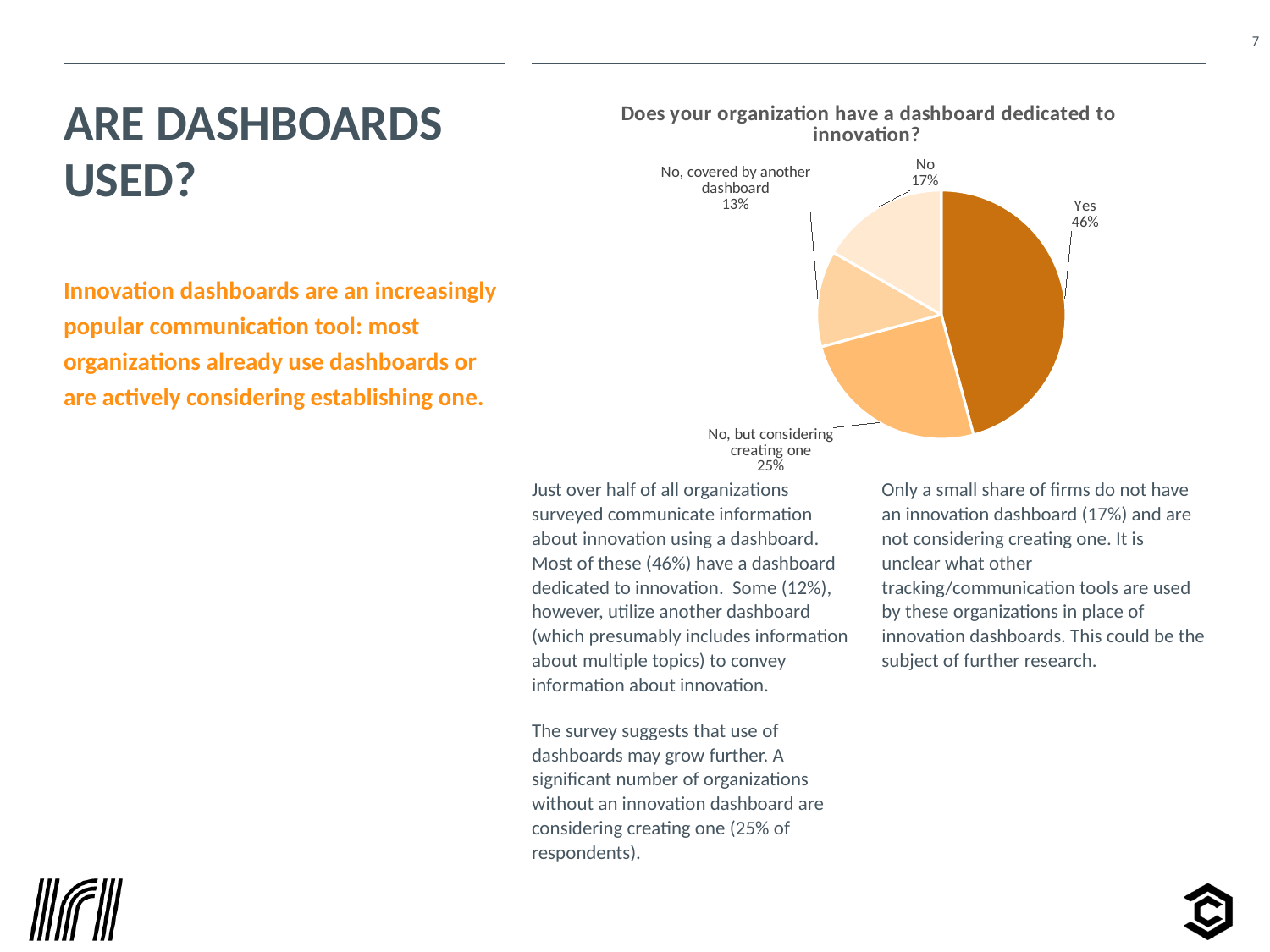
What is the title of the chart? Does your organization have a dashboard dedicated to innovation? What is the combined share of "Yes" and "No, covered by another dashboard"? 59% Which is larger: the share for "No" or the share for "No, covered by another dashboard"? No How many slices does the pie chart have? 4 What percentage of respondents answered "No, but considering creating one"? 25% What percentage of respondents answered "No"? 17% Which response has the smallest share of the pie? No, covered by another dashboard What percentage of respondents answered "Yes"? 46% What type of chart is shown on the slide? pie chart What is the difference in percentage points between "Yes" and "No, but considering creating one"? 21 Which response has the largest share of the pie? Yes What percentage of respondents answered "No, covered by another dashboard"? 13%